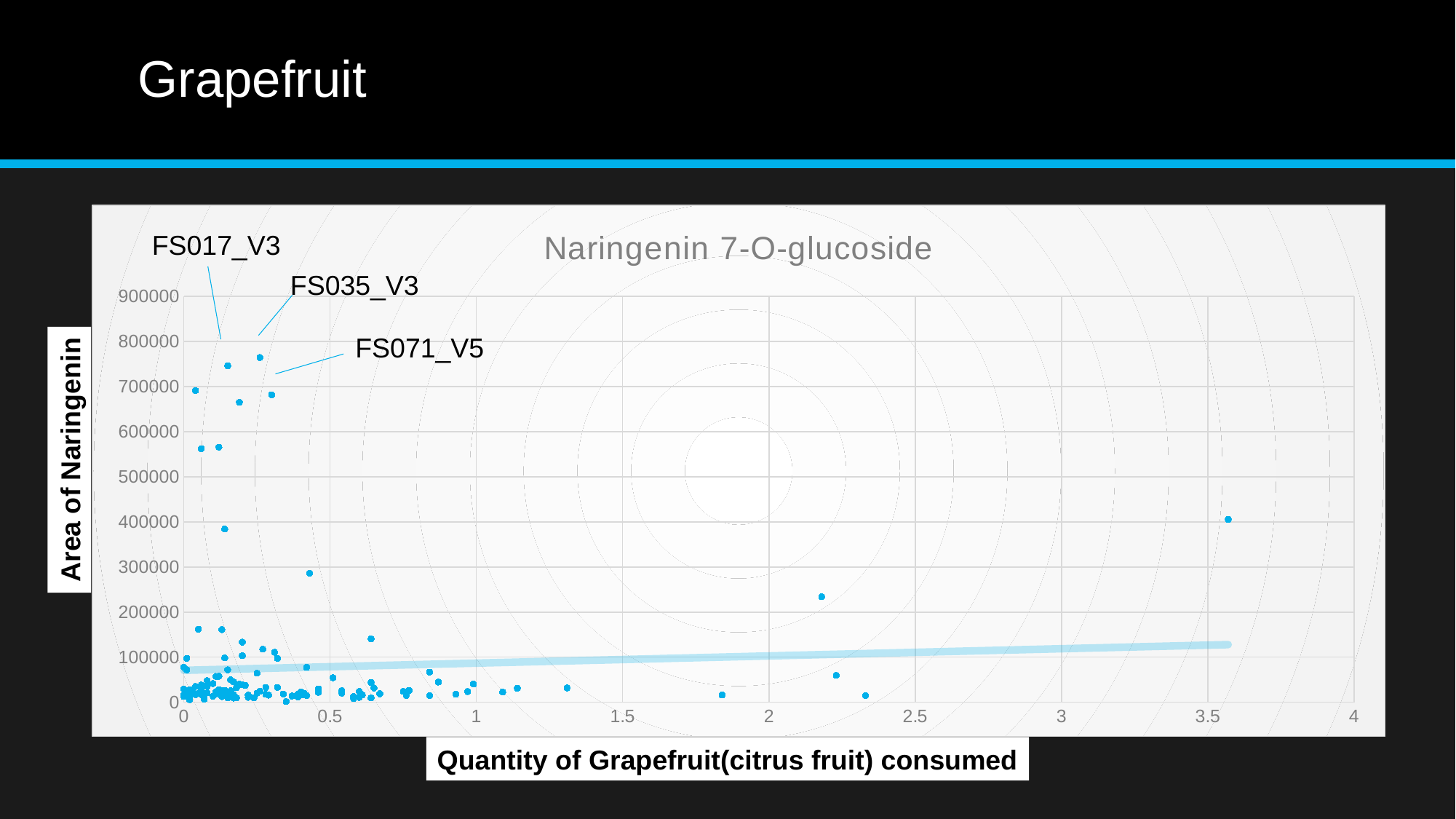
Is the Area of Naringenin for FS035_V3 greater or less than 700000? greater What is the label of the x axis? Quantity of Grapefruit(citrus fruit) consumed Which has a higher Area of Naringenin, FS035_V3 or FS071_V5? FS035_V3 What is the title of the chart? Naringenin 7-O-glucoside Is the Area of Naringenin for FS071_V5 greater or less than 600000? greater Is the Area of Naringenin for FS071_V5 greater or less than 700000? less Of the three labelled points, which has the lowest Area of Naringenin? FS071_V5 How many data points are annotated with a sample label on the chart? 3 What kind of chart is shown on the slide? scatter plot Does the trend line rise or fall as the quantity of grapefruit consumed increases? rises